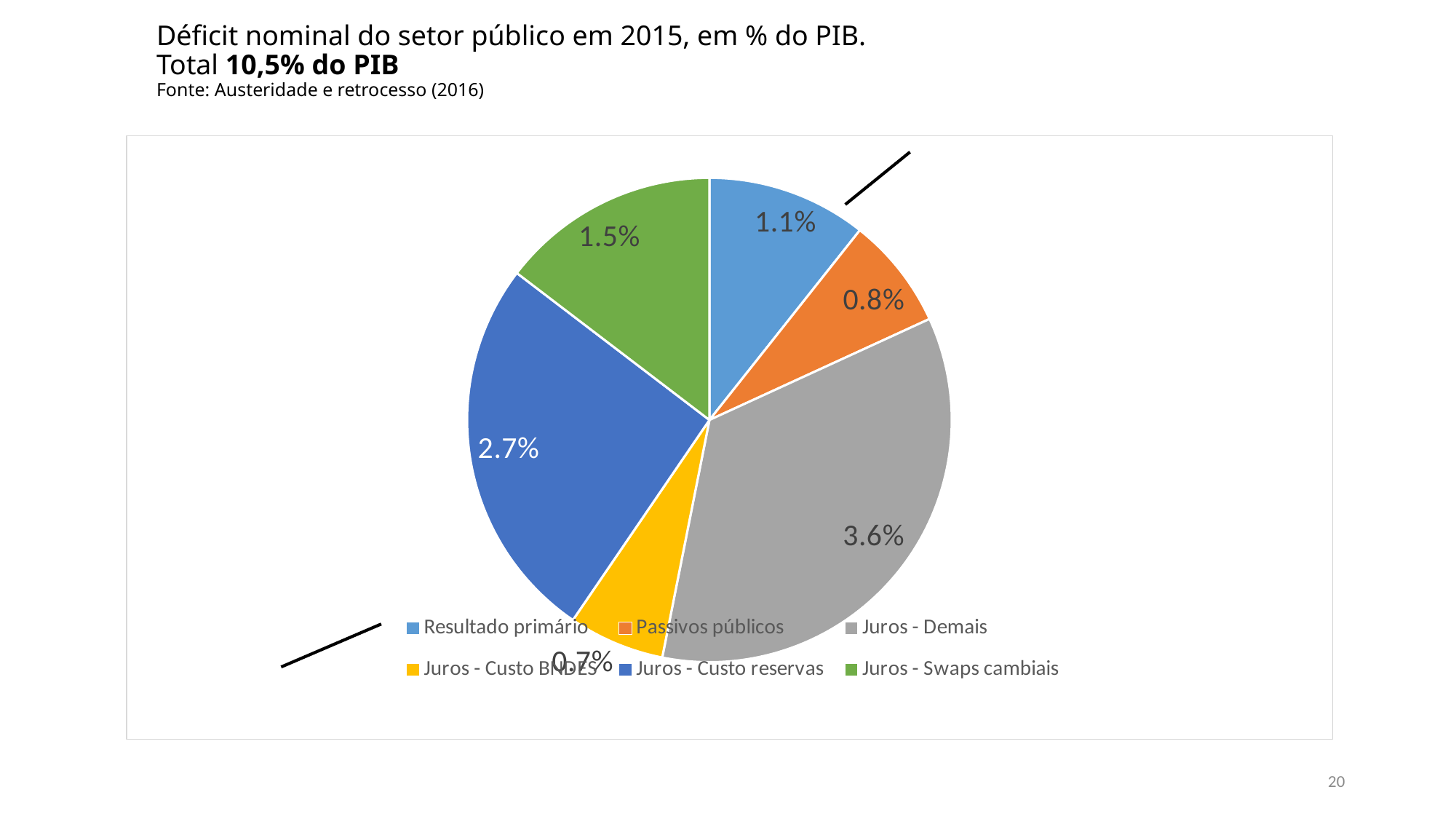
What is the difference between the values for Juros - Demais and Juros - Custo reservas? 0.9% What is the value for Juros - Custo reservas? 2.7% What is the value for Juros - Demais? 3.6% What is the value for Resultado primário? 1.1% Which is larger, the value for Juros - Swaps cambiais or the value for Resultado primário? Juros - Swaps cambiais What is the value for Juros - Swaps cambiais? 1.5% What kind of chart is shown on the slide? pie chart Which category has the largest slice of the pie? Juros - Demais How many slices does the pie chart have? 6 What total is stated in the slide title for the nominal deficit as a share of GDP? 10,5% do PIB What is the value for Passivos públicos? 0.8% Which category has the smallest slice of the pie? Juros - Custo BNDES